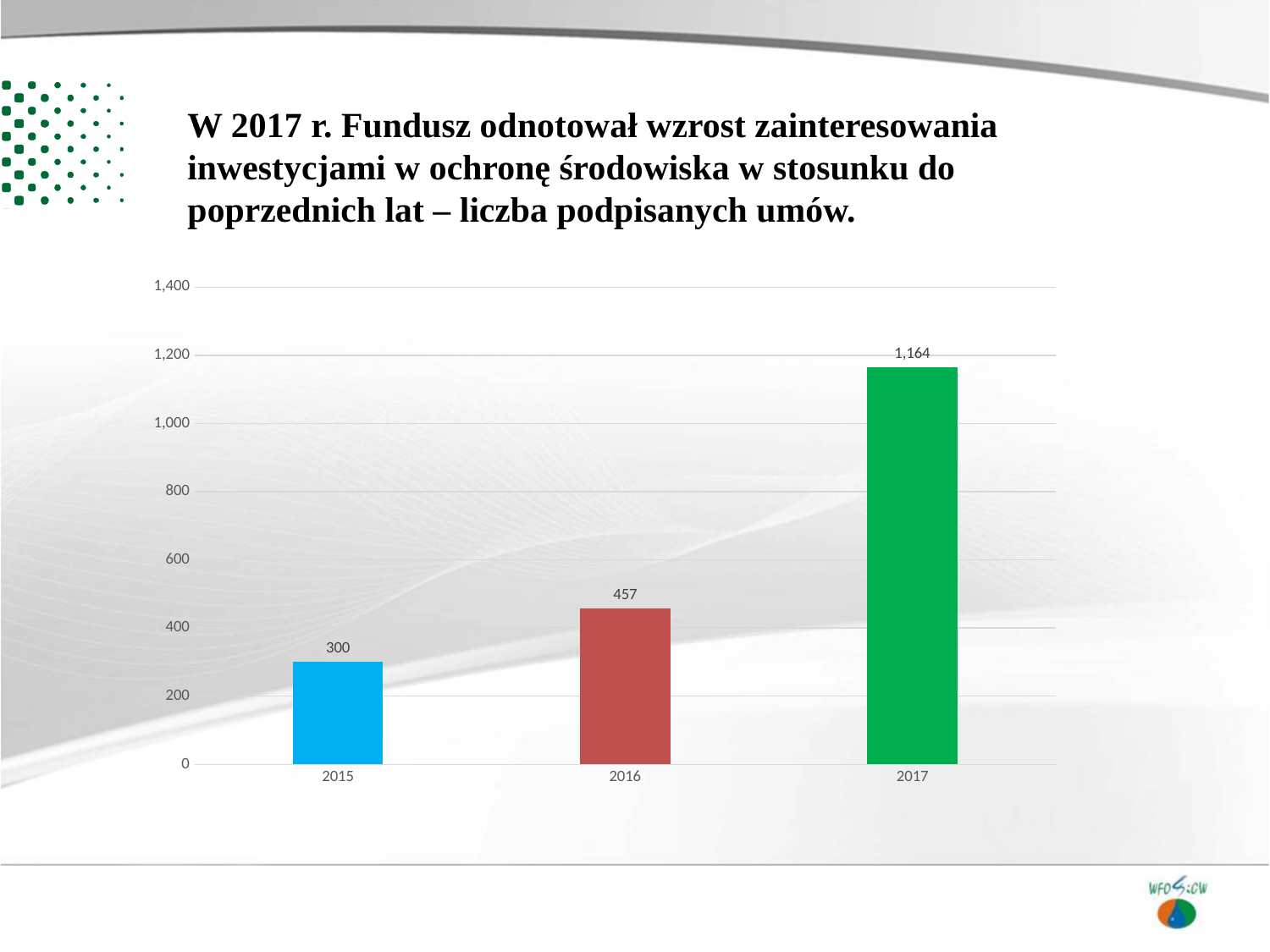
Which year has the lowest value? 2015 How many years are shown on the x axis? 3 What is the value for 2016? 457 Is the value for 2017 greater or less than 1,000? greater What is the difference between the values for 2017 and 2016? 707 What is the difference between the values for 2016 and 2015? 157 Which is larger, the value for 2016 or the value for 2015? 2016 What is the value for 2015? 300 What kind of chart is shown on the slide? bar chart Do the values rise or fall from 2015 to 2017? rise What is the value for 2017? 1,164 Which year has the highest value? 2017